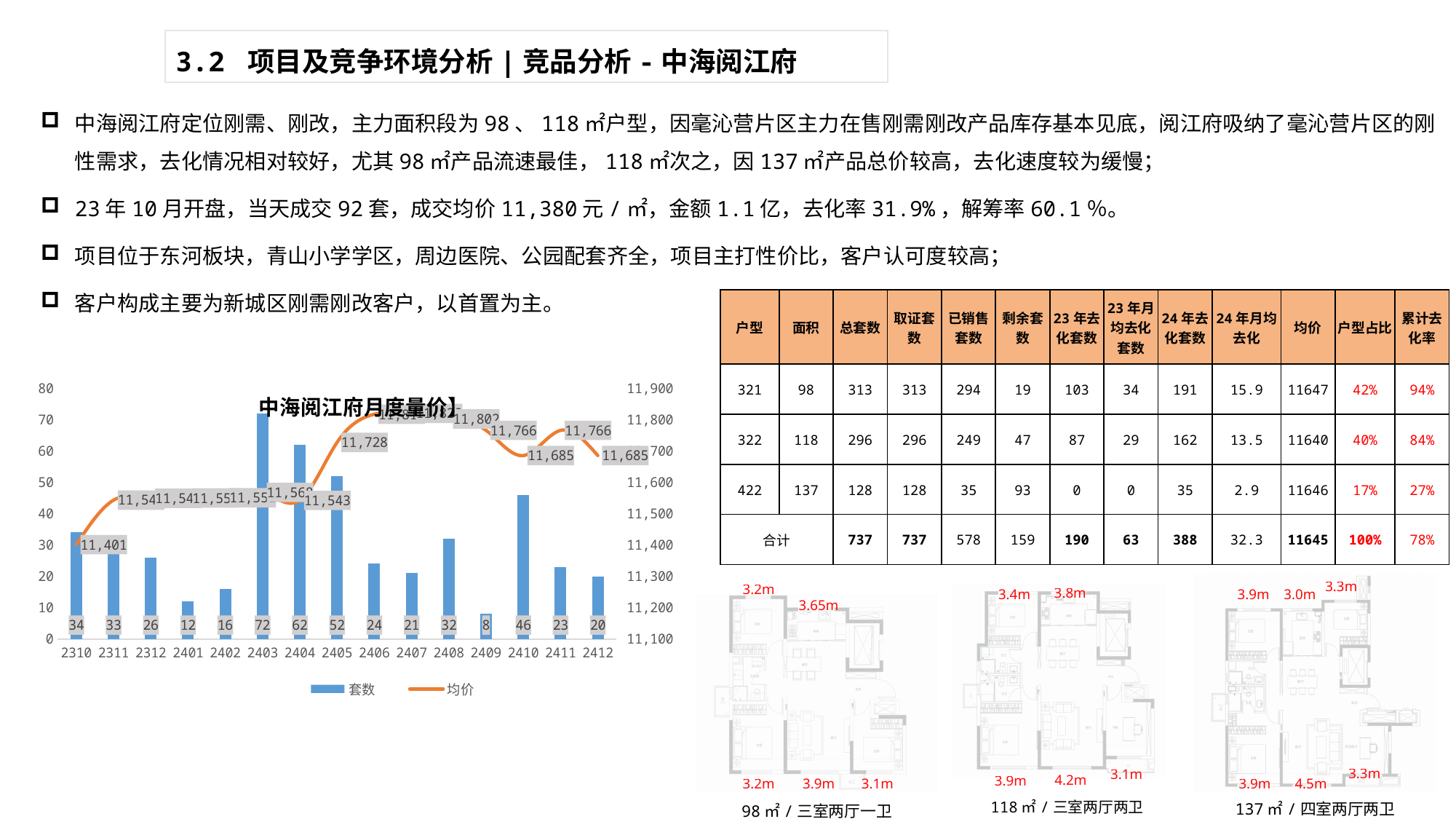
In the 中海阅江府月度量价 chart, what is the 套数 value for 2412? 20 In the 中海阅江府月度量价 chart, which month has the lowest 套数? 2409 What are the two legend entries of the 中海阅江府月度量价 chart? 套数 and 均价 In the 中海阅江府月度量价 chart, what is the difference in 套数 between 2403 and 2404? 10 How many series does the legend of the 中海阅江府月度量价 chart list? 2 In the 中海阅江府月度量价 chart, which month has more 套数, 2405 or 2410? 2405 In the 中海阅江府月度量价 chart, what is the 均价 value for 2310? 11,401 In the 中海阅江府月度量价 chart, what is the 套数 value for 2403? 72 In the 中海阅江府月度量价 chart, which month has the highest 套数? 2403 How many months are shown on the x axis of the 中海阅江府月度量价 chart? 15 What kind of chart is 中海阅江府月度量价? A combined bar and line chart In the 中海阅江府月度量价 chart, what is the 均价 value for 2405? 11,728